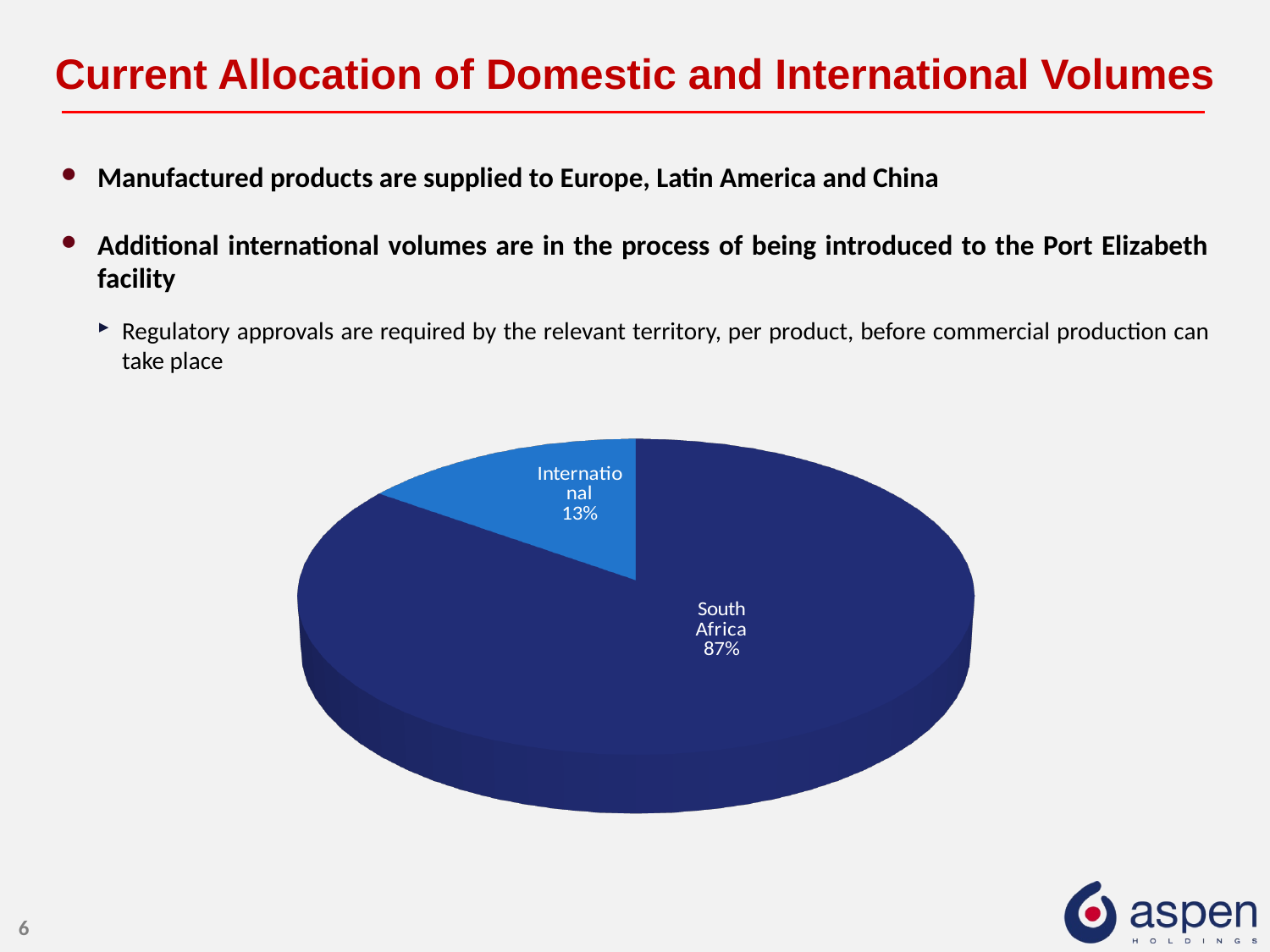
What share of the pie does South Africa account for? 87% What is the total of the two slice percentages shown on the pie chart? 100% Which slice of the pie is shown in the lighter blue colour? International Which is larger, the South Africa slice or the International slice? South Africa What is the difference in percentage points between the South Africa and International slices? 74 How many slices does the pie chart have? 2 Which slice of the pie is the smallest? International What kind of chart is shown on the slide? Pie chart What share of the pie does International account for? 13% What is the title of the slide containing the pie chart? Current Allocation of Domestic and International Volumes Which slice of the pie is the largest? South Africa